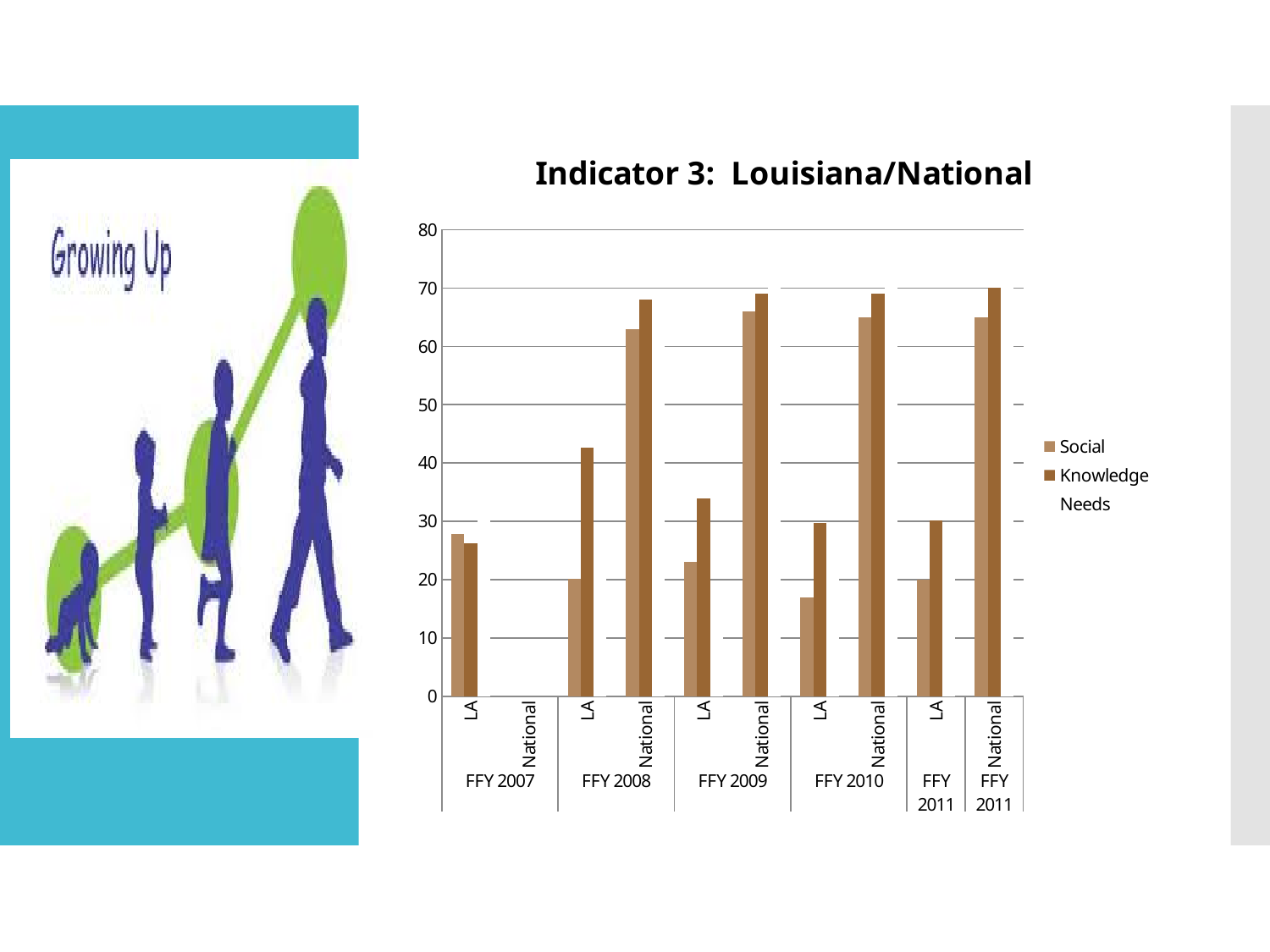
Is the Knowledge Needs value for LA in FFY 2007 greater or less than 30? less In FFY 2009, which has the larger Social value: LA or National? National Is the Knowledge Needs value for LA in FFY 2009 greater or less than 30? greater What is the title of the chart? Indicator 3: Louisiana/National Which category has the lowest Social value? LA, FFY 2010 In FFY 2008, which is larger for LA: Social or Knowledge Needs? Knowledge Needs What kind of chart is shown on the slide? Bar chart Is the Social value for LA in FFY 2010 greater or less than 20? less How many fiscal years (FFY) are shown on the x axis? 5 How many series does the legend list? 2 What are the two series named in the legend? Social and Knowledge Needs